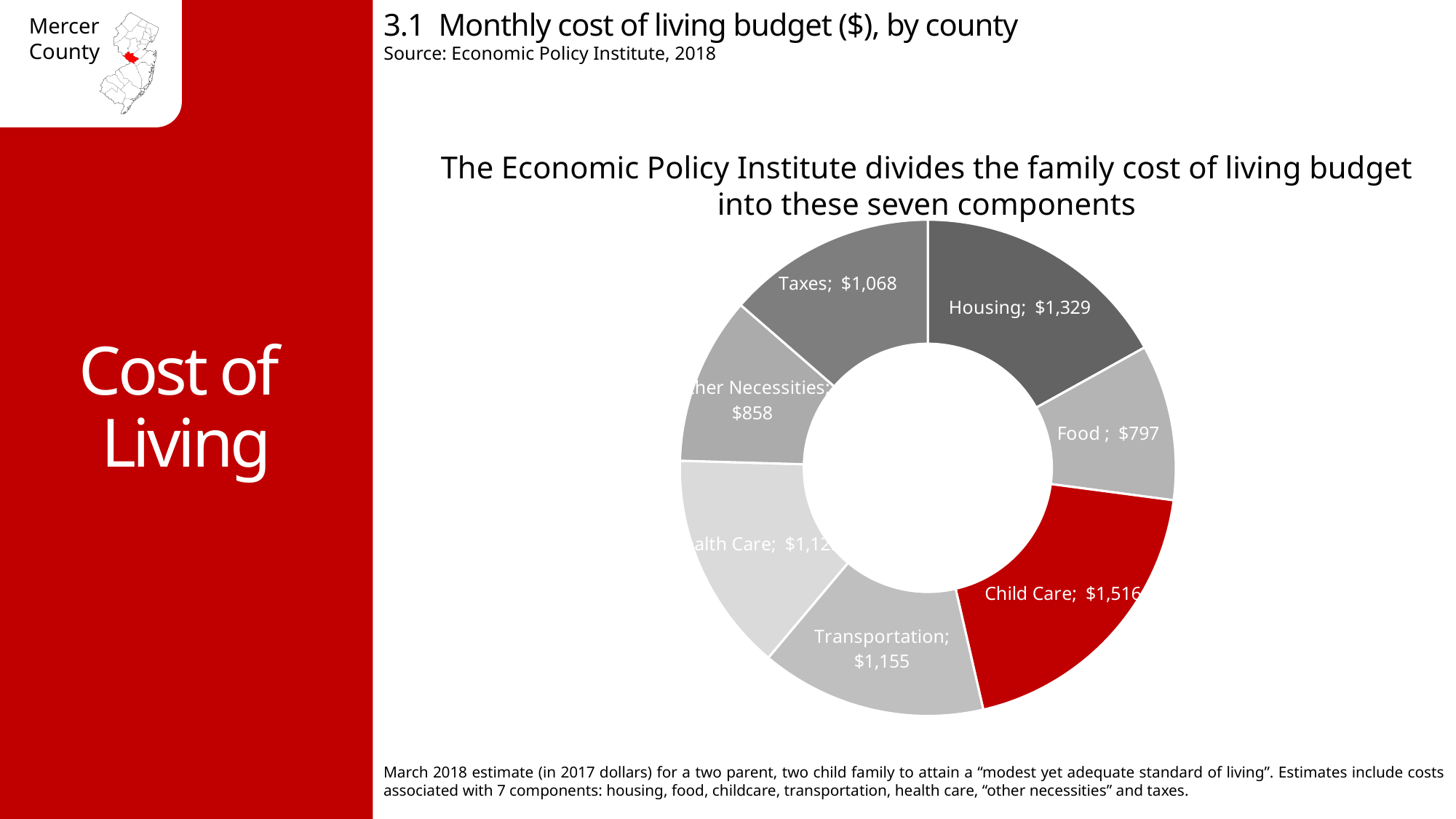
How much more is the monthly cost for Child Care than for Taxes? $448 What kind of chart is shown on the slide? Doughnut (pie) chart What is the monthly cost for Child Care shown on the chart? $1,516 How much more is the monthly cost for Housing than for Food? $532 Which component has the highest monthly cost? Child Care What is the monthly cost for Taxes shown on the chart? $1,068 Which component has the lowest monthly cost? Food What is the monthly cost for Transportation shown on the chart? $1,155 What is the monthly cost for Food shown on the chart? $797 What is the monthly cost for Housing shown on the chart? $1,329 How many components are shown in the chart? 7 Which has a higher monthly cost, Transportation or Taxes? Transportation